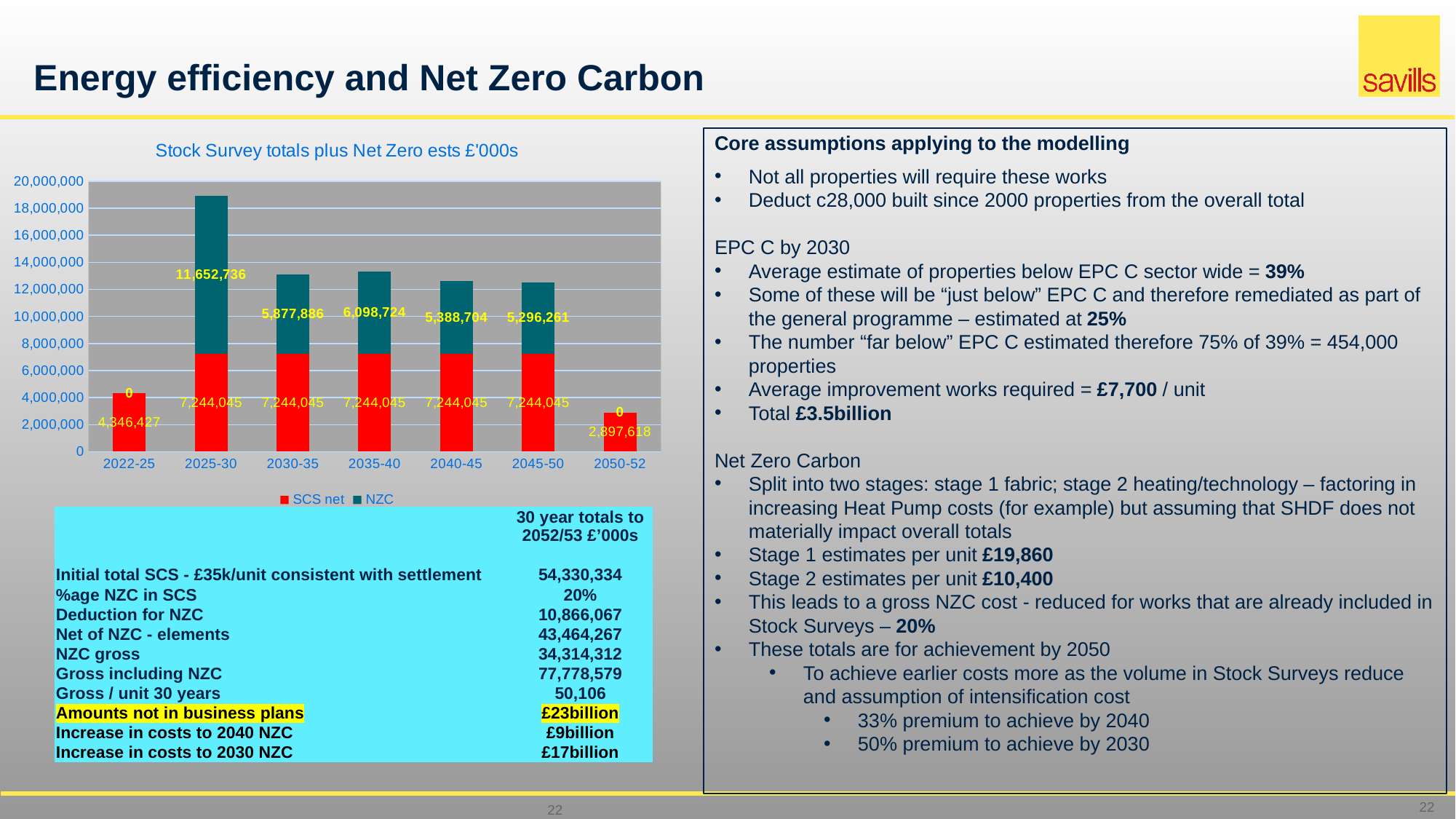
What type of chart is shown on the slide? stacked bar chart How many series does the chart legend list? 2 What is the total of the stacked bar for 2025-30? 18,896,781 How many period categories are shown on the x axis of the chart? 7 What is the SCS net value for 2022-25? 4,346,427 Is the NZC value for 2040-45 larger or smaller than the NZC value for 2045-50? larger What is the difference between the NZC values for 2035-40 and 2030-35? 220,838 Which period has the lowest SCS net value? 2050-52 Which period has the highest NZC value? 2025-30 What is the NZC value for 2025-30? 11,652,736 What is the SCS net value for 2050-52? 2,897,618 What is the title of the chart? Stock Survey totals plus Net Zero ests £'000s